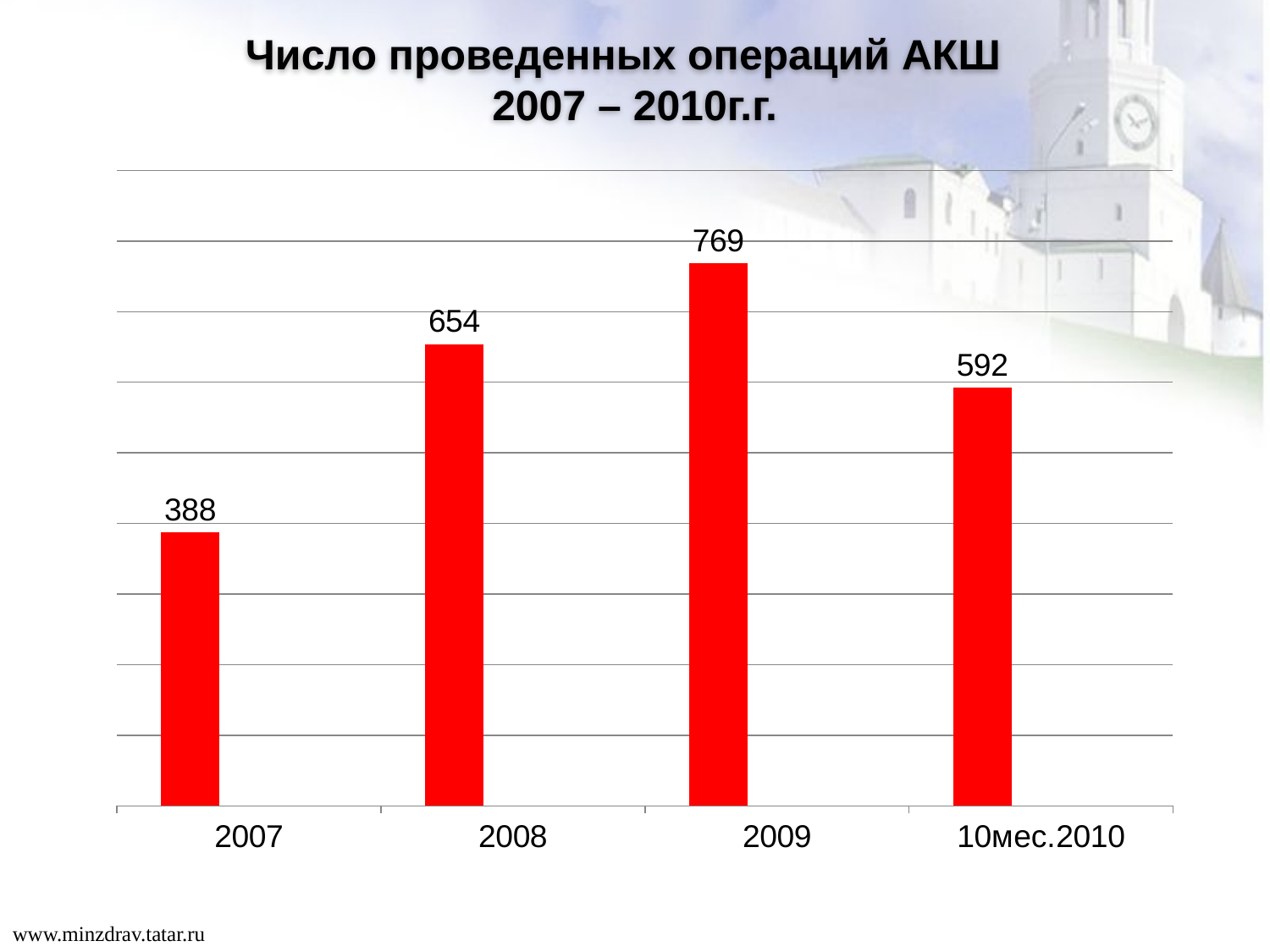
Which is larger, the value for 2008 or the value for 10мес.2010? 2008 What is the title of the chart? Число проведенных операций АКШ 2007 – 2010г.г. What is the difference between the values for 2009 and 2008? 115 What kind of chart is shown on the slide? bar chart What is the value for 2009? 769 How many categories are shown on the x axis? 4 Which category has the highest value? 2009 What is the value for 2007? 388 What is the value for 10мес.2010? 592 Which category has the lowest value? 2007 What is the value for 2008? 654 What is the difference between the values for 2008 and 2007? 266